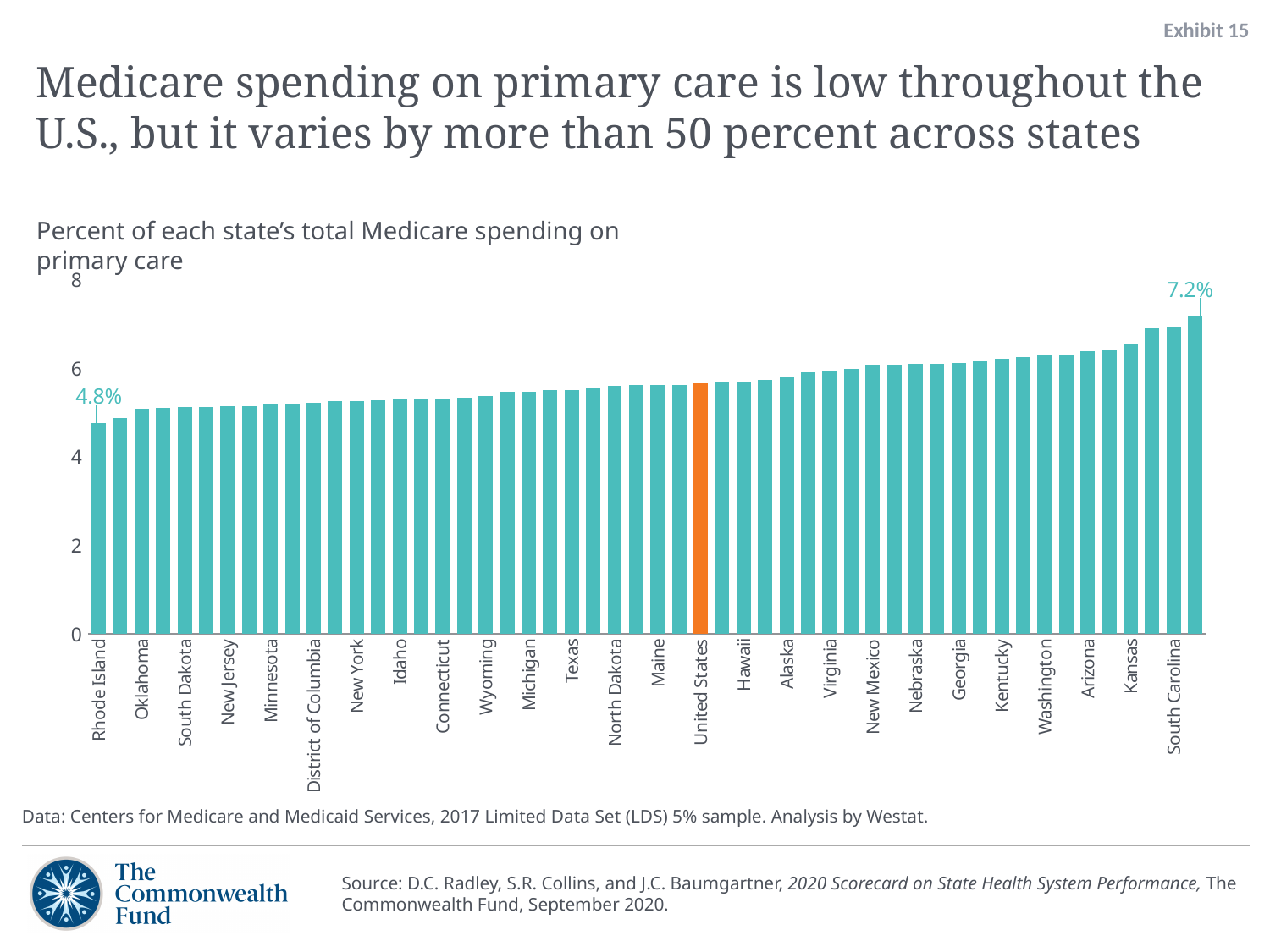
Which has a larger value, Kansas or Texas? Kansas Which has a larger value, Oklahoma or Arizona? Arizona What kind of chart is shown on the slide? Bar chart Which state has the lowest percent of Medicare spending on primary care? Rhode Island What is the value for Rhode Island? 4.8% Is the value for Texas greater or less than 6? less Which bar is highlighted in orange? United States Is the value for Kansas greater or less than 6? greater Do the values rise or fall moving from left to right along the x axis? Rise